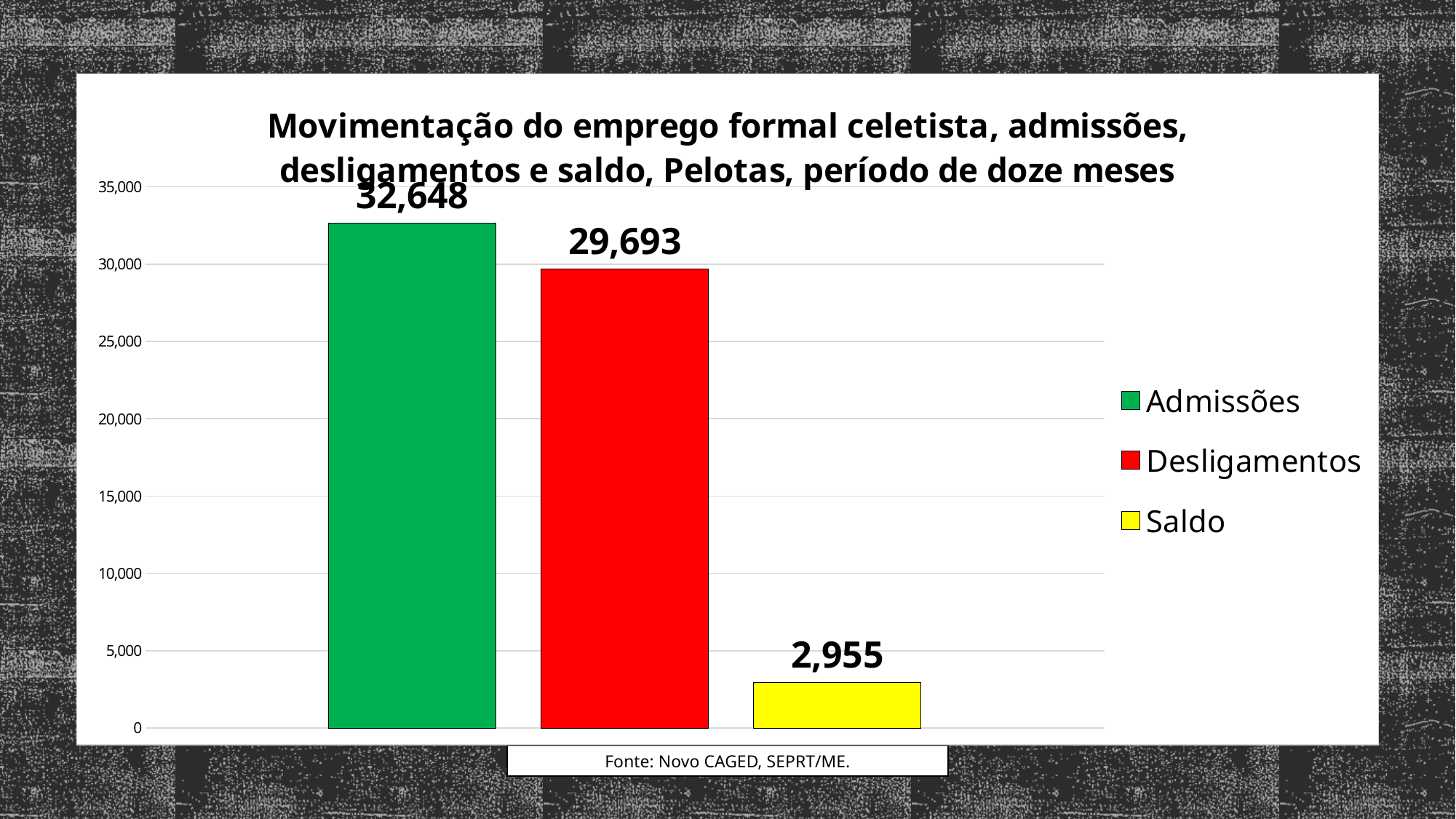
Which series has the highest value? Admissões How many bars are plotted in the chart? 3 What is the difference between Admissões and Desligamentos? 2,955 Which is larger, Desligamentos or Saldo? Desligamentos Which series has the lowest value? Saldo How many series does the legend list? 3 Is the value for Desligamentos greater or less than 30,000? less What kind of chart is shown on the slide? bar chart What is the value for Saldo? 2,955 What is the value for Admissões? 32,648 What colour is the bar for Saldo? yellow What is the value for Desligamentos? 29,693